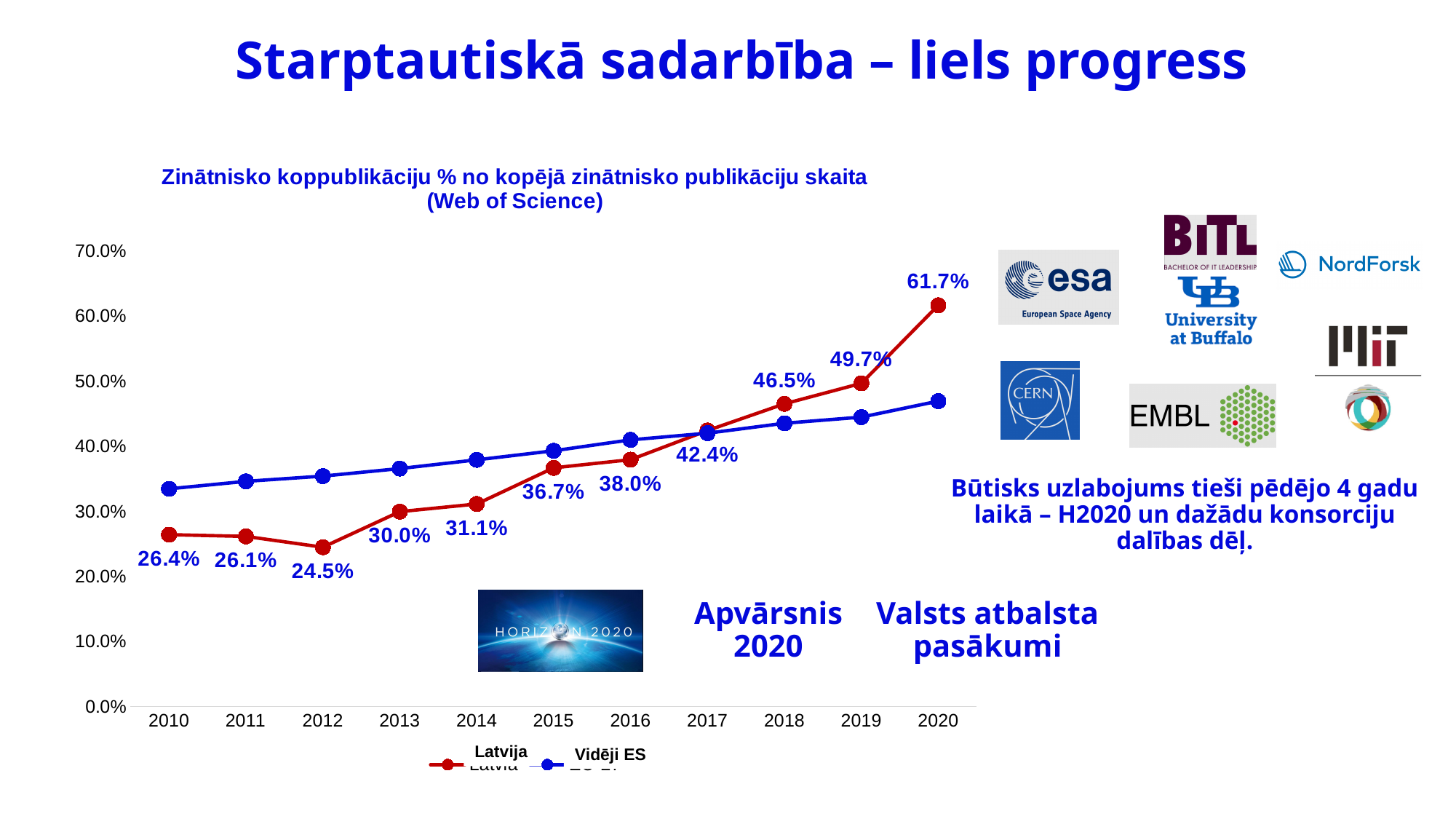
Is the Vidēji ES value for 2010 greater or less than 30.0%? greater What is the value for Latvija in 2012? 24.5% What is the difference between the Latvija values in 2020 and 2019? 12.0% How many years are shown on the x axis? 11 What is the value for Latvija in 2017? 42.4% What type of chart is shown on the slide? line chart How many series does the legend list? 2 Does the Latvija series rise or fall from 2013 to 2020? rise In which year is the Latvija value highest? 2020 Which is larger for Latvija: the value in 2015 or the value in 2016? 2016 What is the value for Latvija in 2020? 61.7% In which year is the Latvija value lowest? 2012